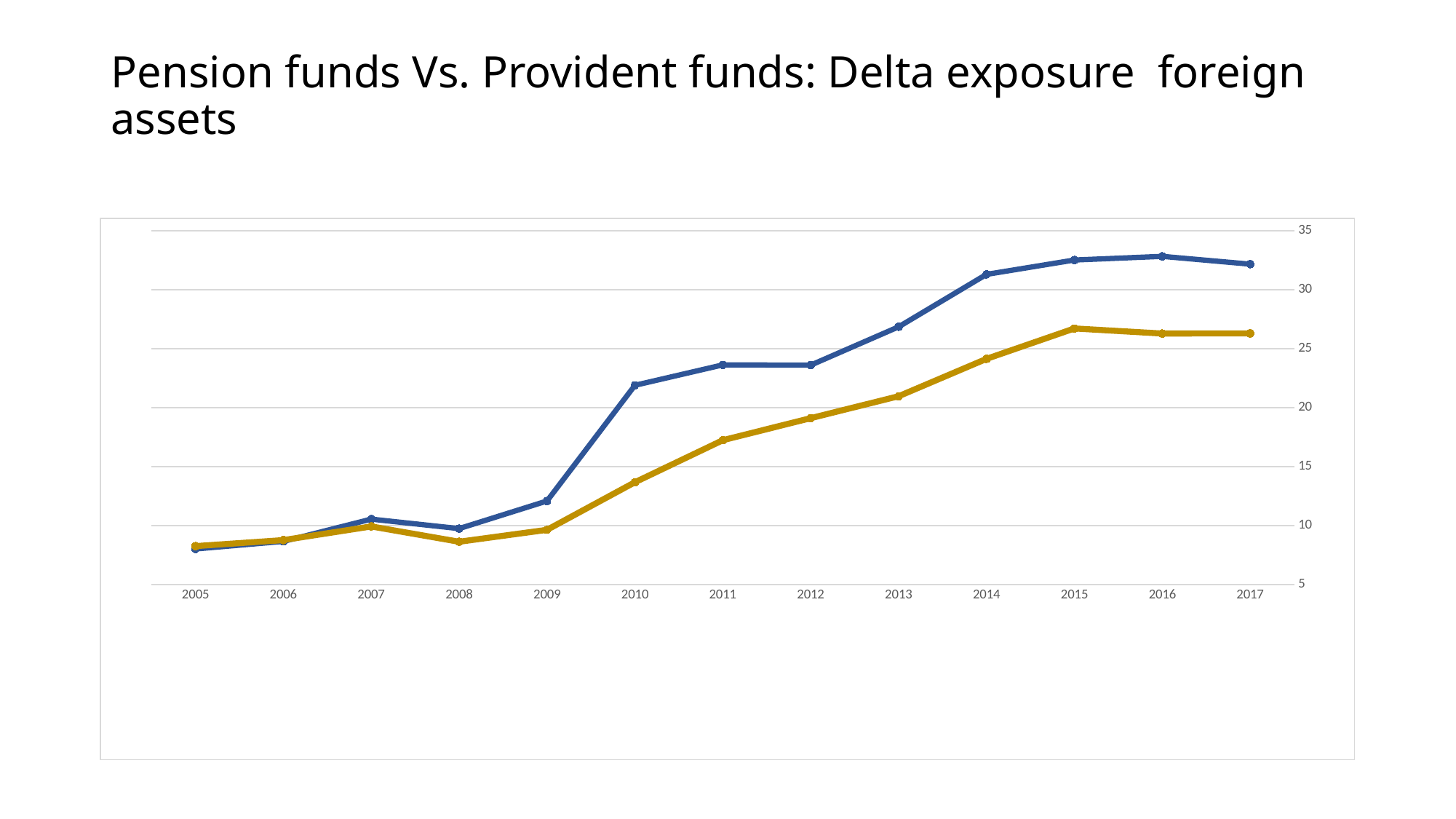
How many lines are plotted on the chart? 2 Overall, do the values of the gold line rise or fall from 2005 to 2017? rise Is the value of the gold line in 2010 greater or less than 15? less Is the value of the blue line in 2005 greater or less than 10? less In 2017, which line has the higher value, the blue line or the gold line? the blue line How many years are shown along the x axis of the chart? 13 Is the value of the blue line in 2010 greater or less than 20? greater What is the highest value shown on the y axis? 35 What kind of chart is shown on the slide? line chart What is the first year shown on the x axis? 2005